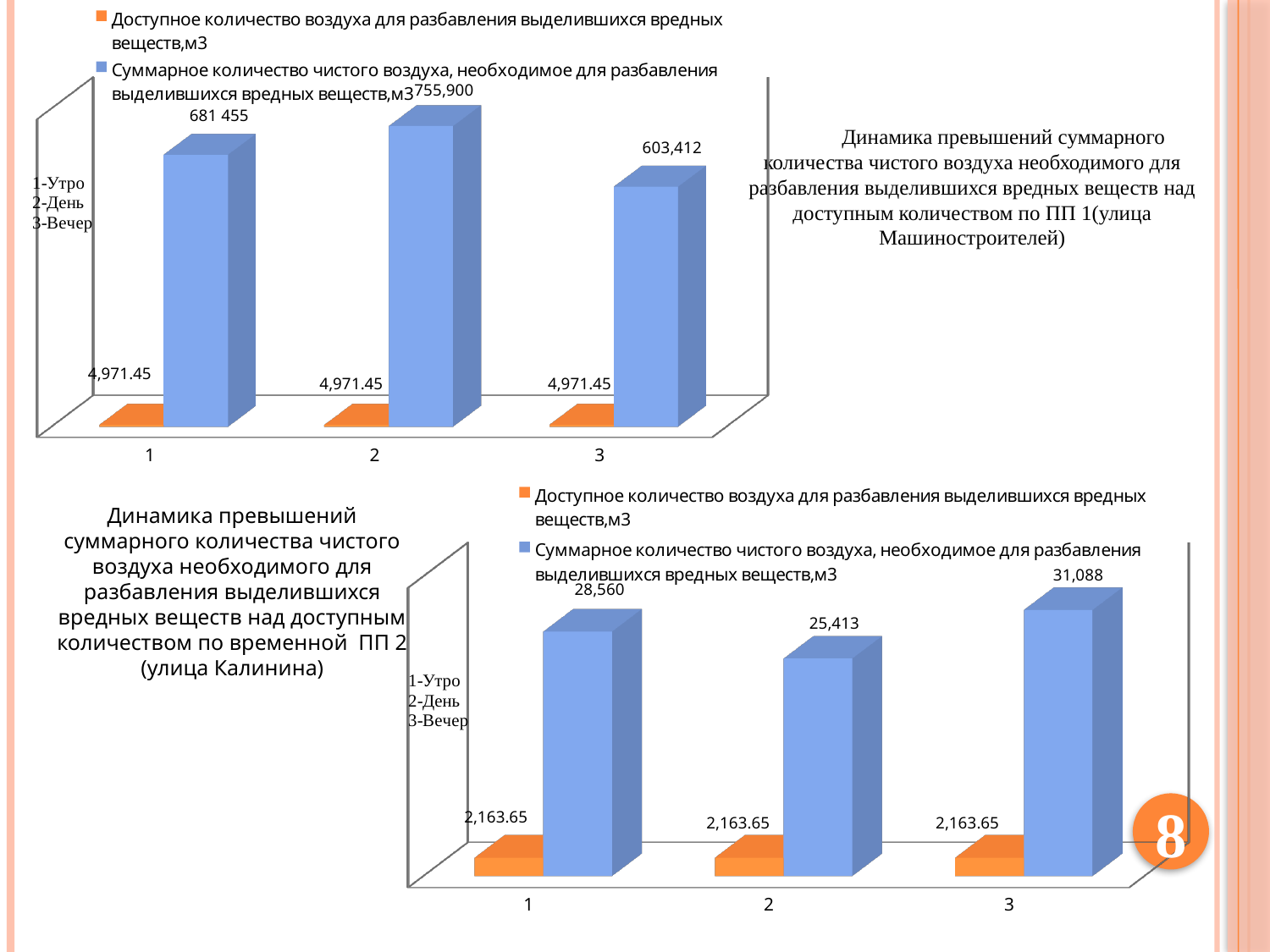
On the top chart, what is the value of the blue series for category 3? 603,412 On the top chart, which category has the highest value for the blue series? 2 On the top chart, what is the value of the orange series (Доступное количество воздуха) for category 1? 4,971.45 On the top chart, what is the difference between the blue series values for category 2 and category 3? 152,488 On the bottom chart, what is the difference between the blue series values for category 3 and category 2? 5,675 How many series does the legend of the bottom chart list? 2 On the bottom chart, which is larger: the blue series value for category 1 or for category 2? category 1 On the bottom chart, which category has the highest value for the blue series? 3 On the bottom chart, what is the value of the blue series for category 1? 28,560 On the top chart, which category has the lowest value for the blue series? 3 On the bottom chart, what is the value of the orange series for category 2? 2,163.65 On the top chart, what is the value of the blue series (Суммарное количество чистого воздуха) for category 2? 755,900